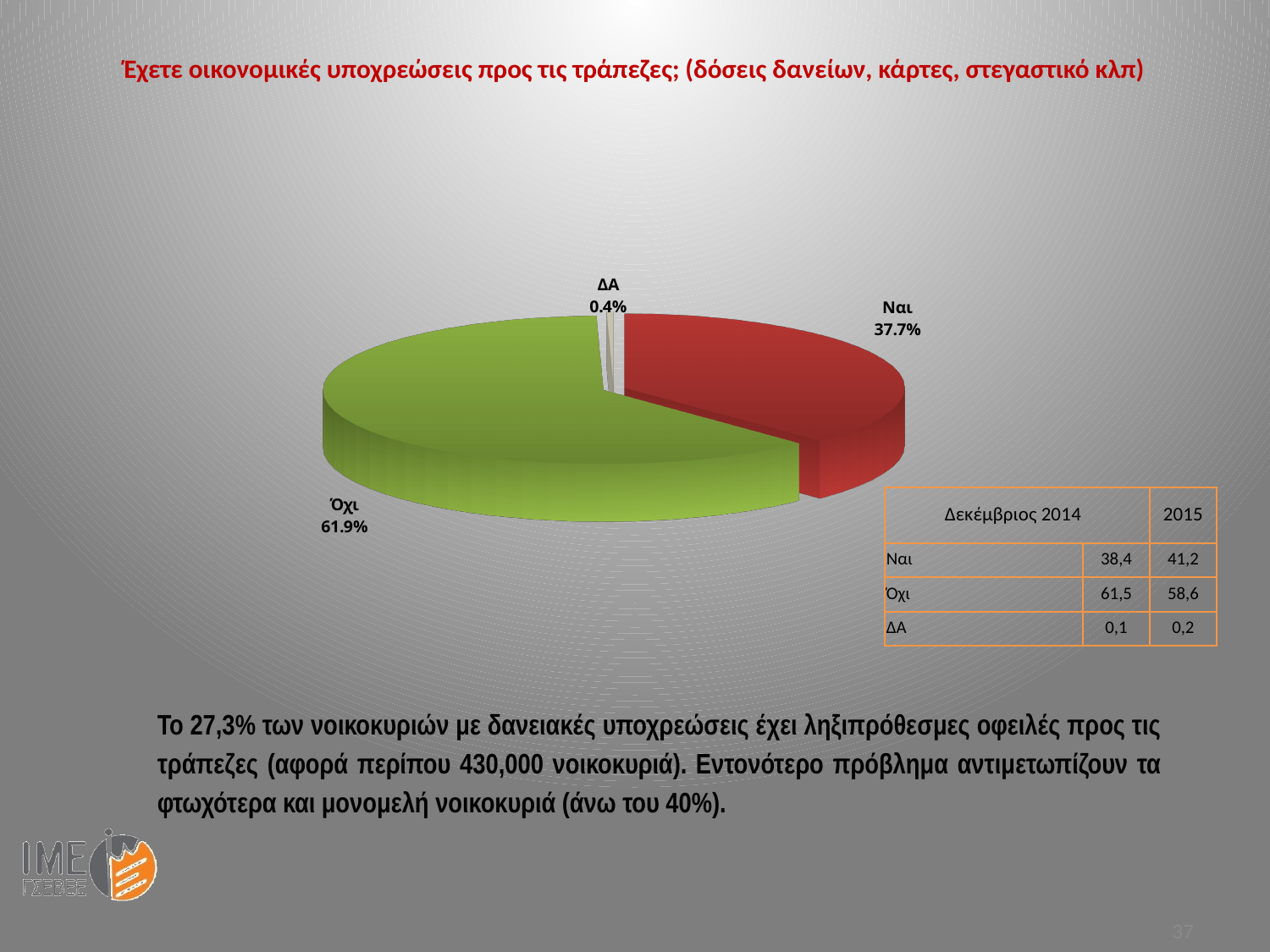
What type of chart is shown on the slide? Pie chart What colour is the 'Όχι' slice in the pie chart? Green How many slices does the pie chart have? 3 Which category has the largest slice in the pie chart? Όχι Which is larger in the pie chart, 'Ναι' or 'Όχι'? Όχι Which category has the smallest slice in the pie chart? ΔΑ What is the difference between the 'Όχι' and 'Ναι' values in the pie chart? 24.2% What is the value shown for 'Ναι' in the pie chart? 37.7% What is the value shown for 'ΔΑ' in the pie chart? 0.4% What share of the pie does the 'Όχι' slice represent? 61.9% What colour is the 'Ναι' slice in the pie chart? Red